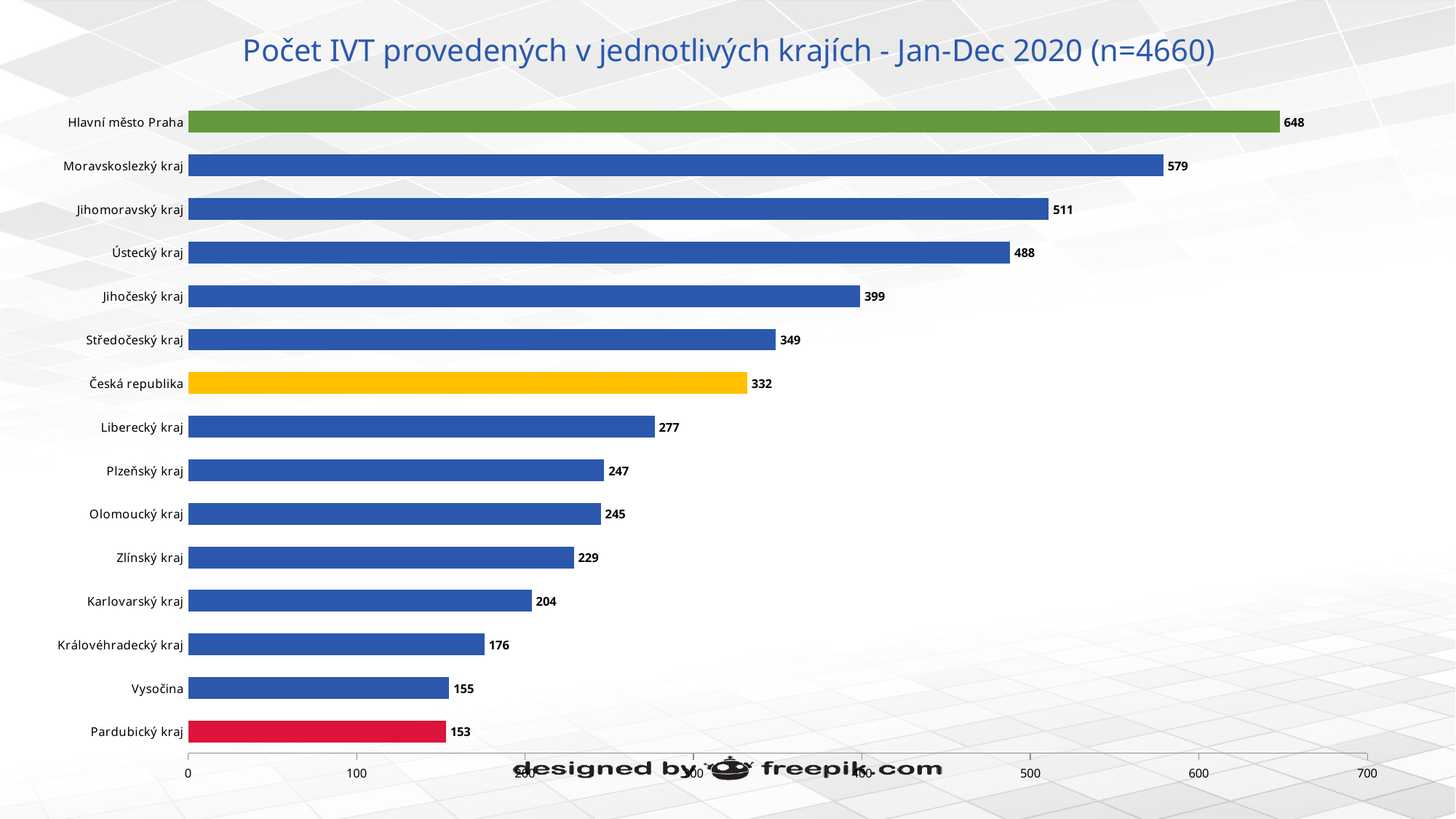
How many categories are shown in the chart? 15 Which is larger, the value for Liberecký kraj or the value for Plzeňský kraj? Liberecký kraj Which category has the highest value? Hlavní město Praha What is the value for Karlovarský kraj? 204 What kind of chart is shown on the slide? bar chart Is the value for Jihočeský kraj greater or less than 300? greater What is the value for Česká republika? 332 What is the value for Hlavní město Praha? 648 Which category has the lowest value? Pardubický kraj Which category's bar is coloured yellow? Česká republika What is the title of the chart? Počet IVT provedených v jednotlivých krajích - Jan-Dec 2020 (n=4660) What is the difference between the values for Moravskoslezský kraj and Jihomoravský kraj? 68